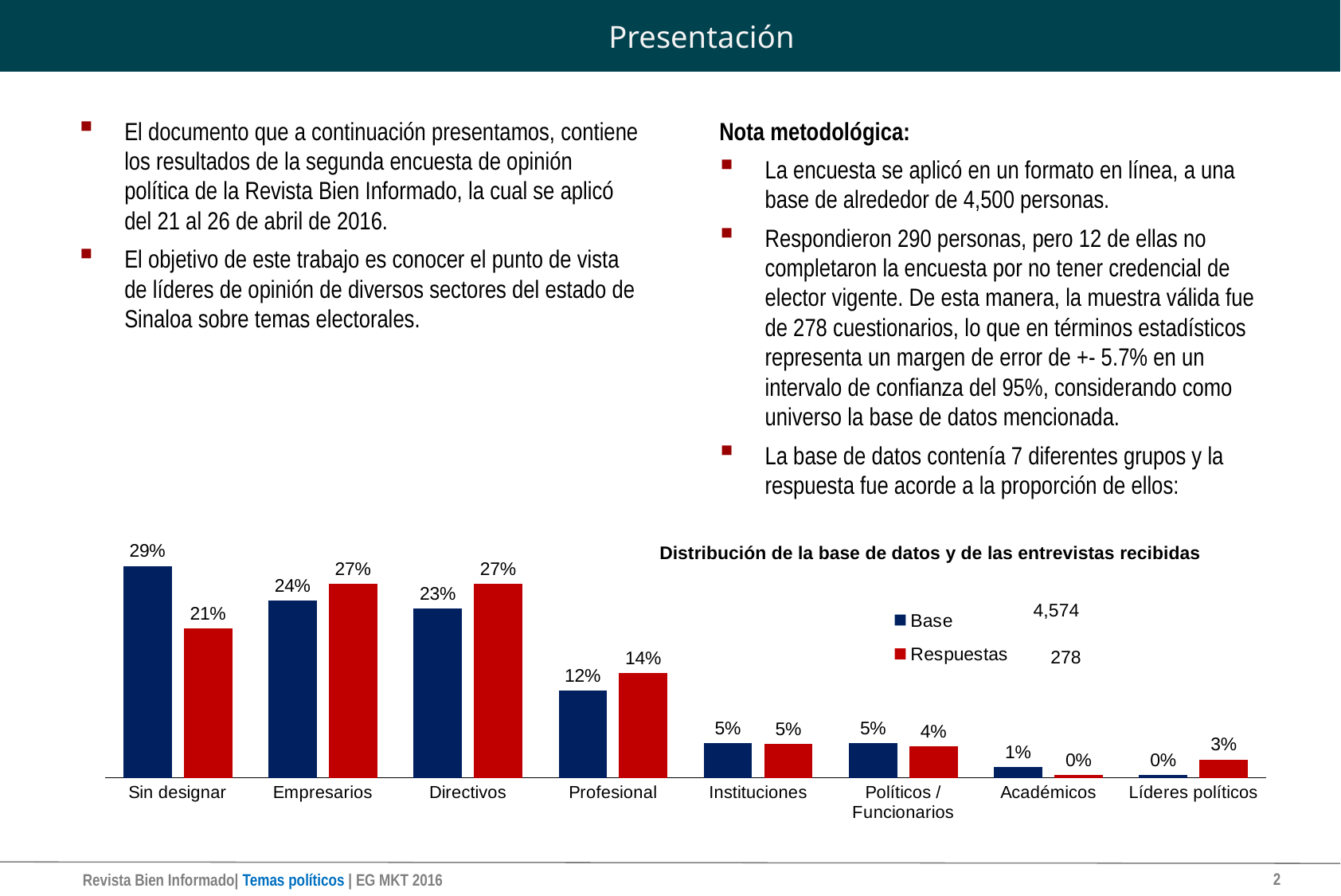
What is the Respuestas value for Directivos? 27% Which category has the lowest Base value? Líderes políticos What is the title of the chart? Distribución de la base de datos y de las entrevistas recibidas What is the Respuestas value for Líderes políticos? 3% Which category has the highest Base value? Sin designar What is the difference between the Base and Respuestas values for Sin designar? 8% Which is larger for Profesional, the Base value or the Respuestas value? Respuestas What is the Base value for Sin designar? 29% How many categories are shown on the x axis? 8 What kind of chart is shown on the slide? Bar chart What is the difference between the Respuestas and Base values for Empresarios? 3% How many series does the legend list? 2